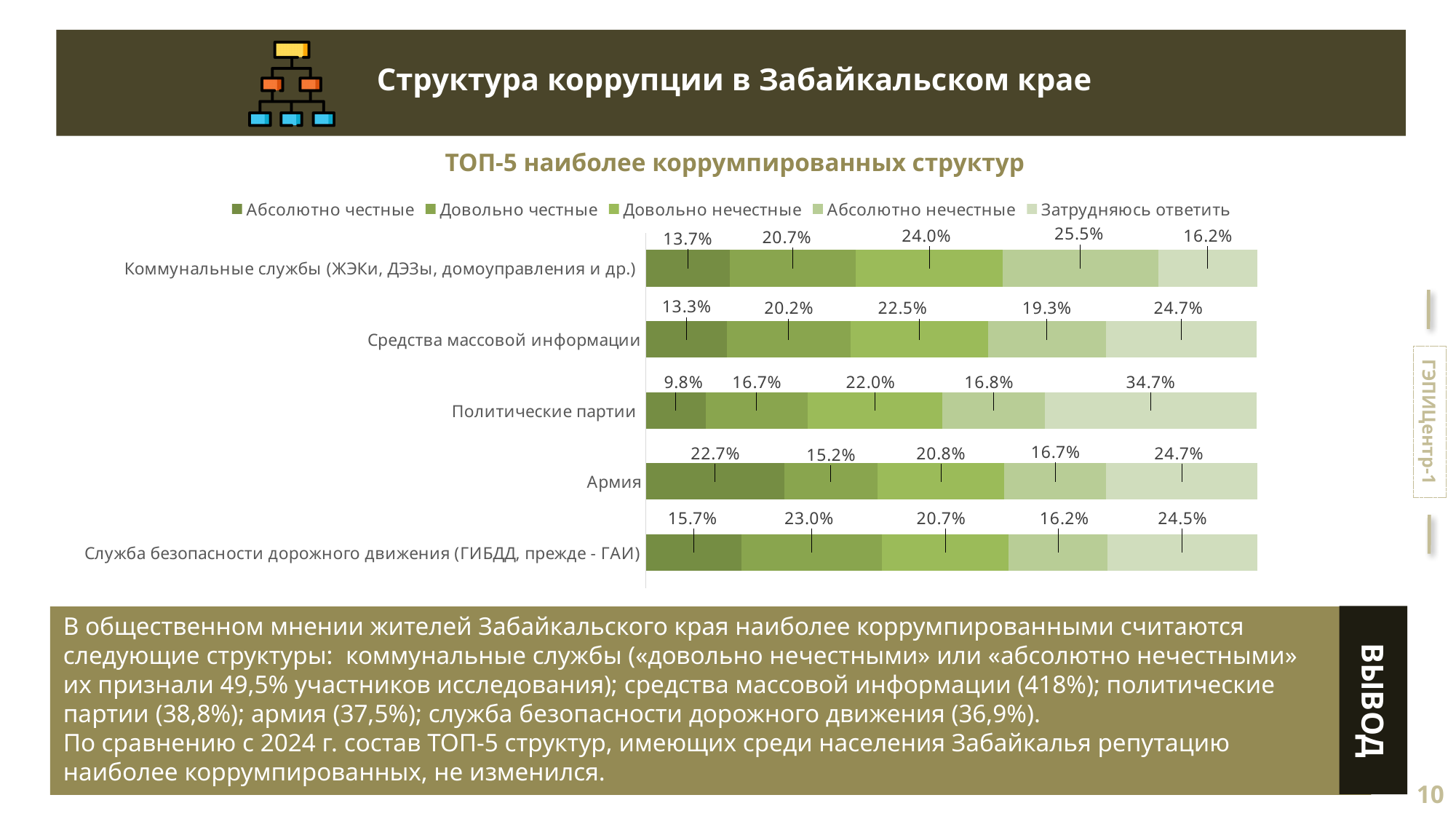
What is the difference between the 'Абсолютно честные' values for 'Армия' and 'Коммунальные службы (ЖЭКи, ДЭЗы, домоуправления и др.)'? 9.0% Which category has the highest value for 'Затрудняюсь ответить'? Политические партии How many series does the legend list? 5 What is the combined value of 'Довольно нечестные' and 'Абсолютно нечестные' for 'Коммунальные службы (ЖЭКи, ДЭЗы, домоуправления и др.)'? 49.5% What kind of chart is shown on the slide? Stacked bar chart What is the value for 'Затрудняюсь ответить' for 'Политические партии'? 34.7% What is the value for 'Абсолютно честные' for 'Армия'? 22.7% How many categories are shown in the chart? 5 Which category has the lowest value for 'Абсолютно честные'? Политические партии What is the value for 'Довольно честные' for 'Служба безопасности дорожного движения (ГИБДД, прежде - ГАИ)'? 23.0% What is the value for 'Абсолютно нечестные' for 'Коммунальные службы (ЖЭКи, ДЭЗы, домоуправления и др.)'? 25.5% Which has the larger 'Абсолютно нечестные' value: 'Коммунальные службы (ЖЭКи, ДЭЗы, домоуправления и др.)' or 'Средства массовой информации'? Коммунальные службы (ЖЭКи, ДЭЗы, домоуправления и др.)